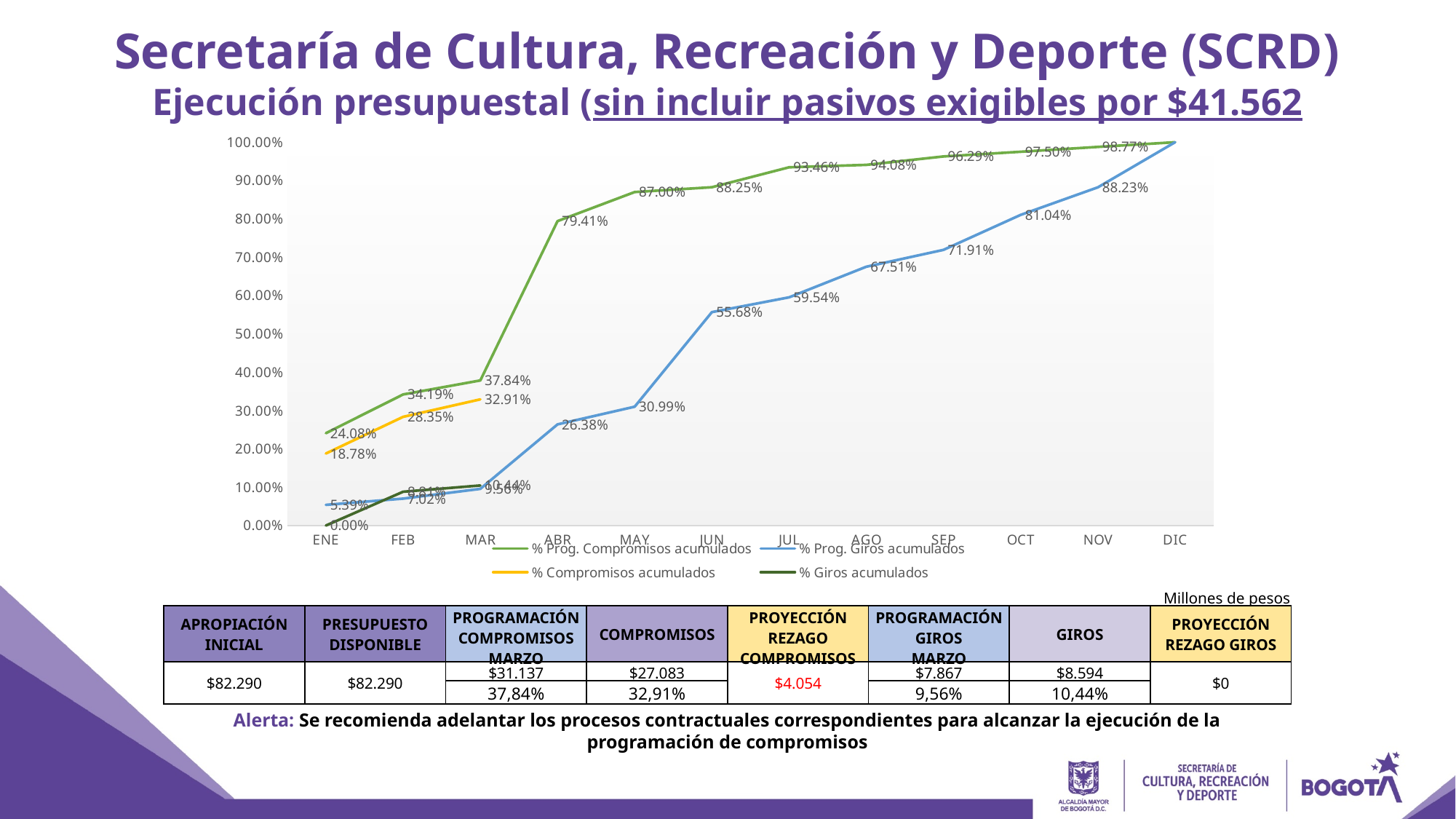
What is the value of % Prog. Compromisos acumulados in ABR? 79.41% How many series does the chart legend list? 4 What is the value of % Prog. Compromisos acumulados in NOV? 98.77% In MAY, which is larger: % Prog. Compromisos acumulados or % Prog. Giros acumulados? % Prog. Compromisos acumulados What is the difference between % Prog. Compromisos acumulados (37.84%) and % Compromisos acumulados (32.91%) in MAR? 4.93 percentage points What colour is the % Prog. Giros acumulados line in the chart? Blue What kind of chart is shown on the slide? Line chart What is the value of % Compromisos acumulados in MAR? 32.91% Is the value of % Prog. Compromisos acumulados in DIC greater or less than 90.00%? greater What is the value of % Prog. Giros acumulados in JUN? 55.68% Does the % Prog. Giros acumulados line rise or fall from ENE to DIC? Rises How many months are shown along the x axis of the chart? 12